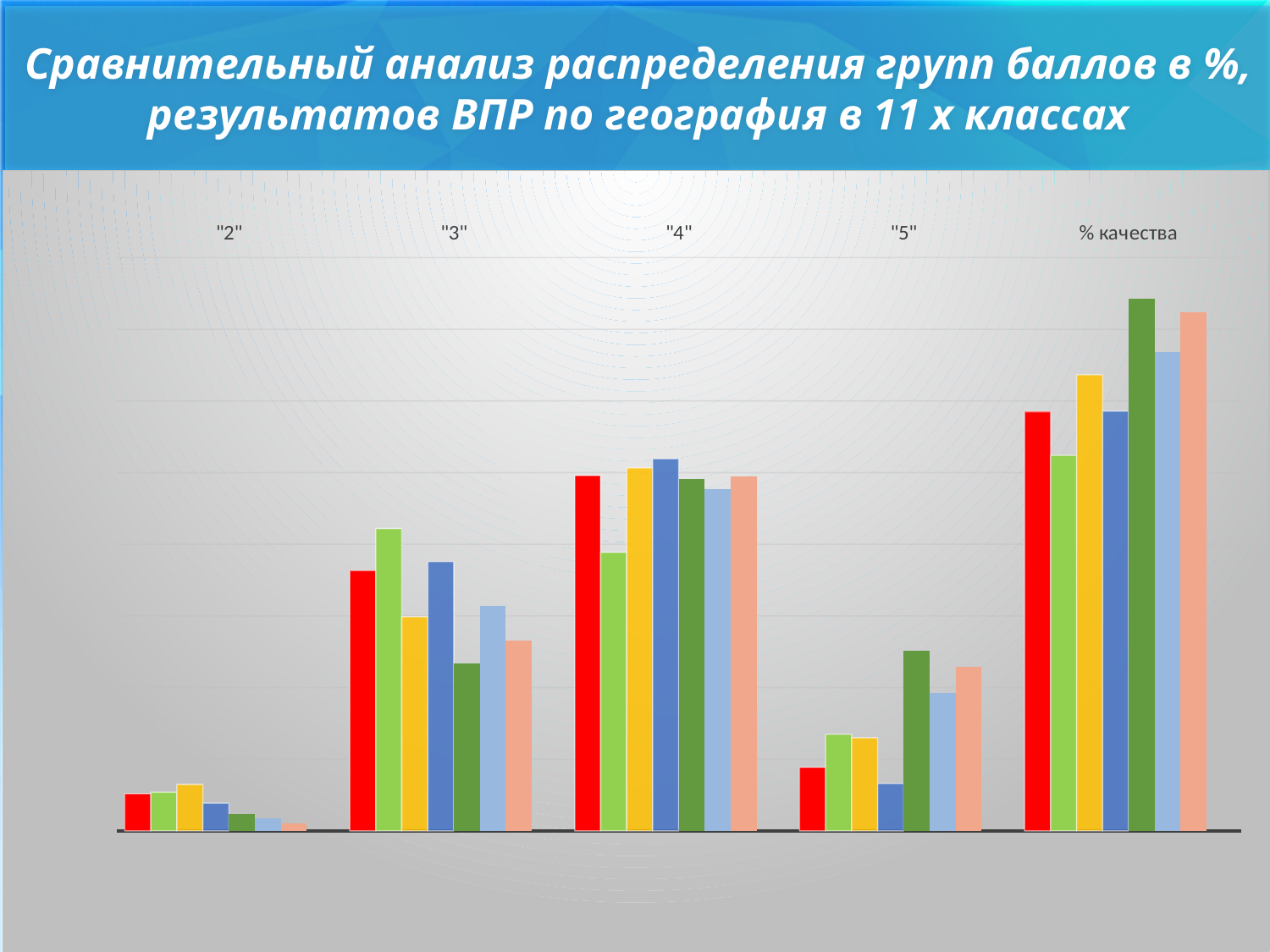
What is the label of the last category on the x axis? % качества Are the bars for category "3" taller or shorter than the bars for category "2"? taller Are the bars for category "5" taller or shorter than the bars for category "4"? shorter Which category on the x axis has the tallest bars overall? % качества Which category on the x axis has the lowest bars overall? "2" What subject do the ВПР results in the slide title refer to? география Do the bar heights rise or fall going from category "2" to category "4"? rise What kind of chart is shown on the slide? bar chart How many categories are shown along the x axis of the chart? 5